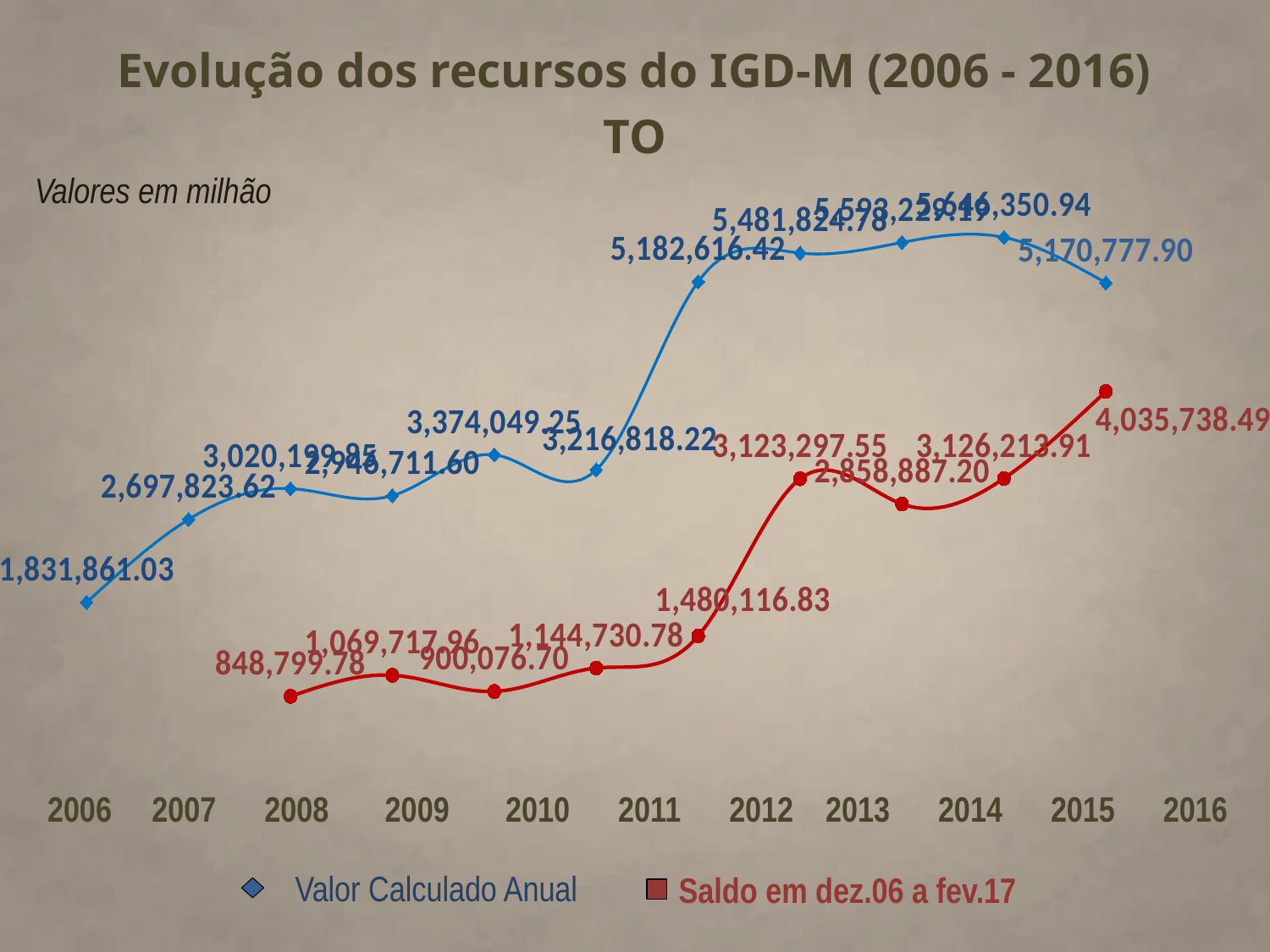
In which year is 'Valor Calculado Anual' lowest? 2006 What is the value of 'Saldo em dez.06 a fev.17' for 2011? 1,144,730.78 Which series has the larger value in 2012, 'Valor Calculado Anual' or 'Saldo em dez.06 a fev.17'? Valor Calculado Anual What is the value of 'Valor Calculado Anual' for 2012? 5,182,616.42 What is the title of the chart? Evolução dos recursos do IGD-M (2006 - 2016) TO What is the difference between 'Valor Calculado Anual' and 'Saldo em dez.06 a fev.17' in 2016? 1,135,039.41 What is the value of 'Saldo em dez.06 a fev.17' for 2016? 4,035,738.49 What type of chart is shown on the slide? Line chart What is the value of 'Valor Calculado Anual' for 2006? 1,831,861.03 In which year is 'Saldo em dez.06 a fev.17' highest? 2016 How many series does the legend list? 2 How many years are shown on the x axis? 11